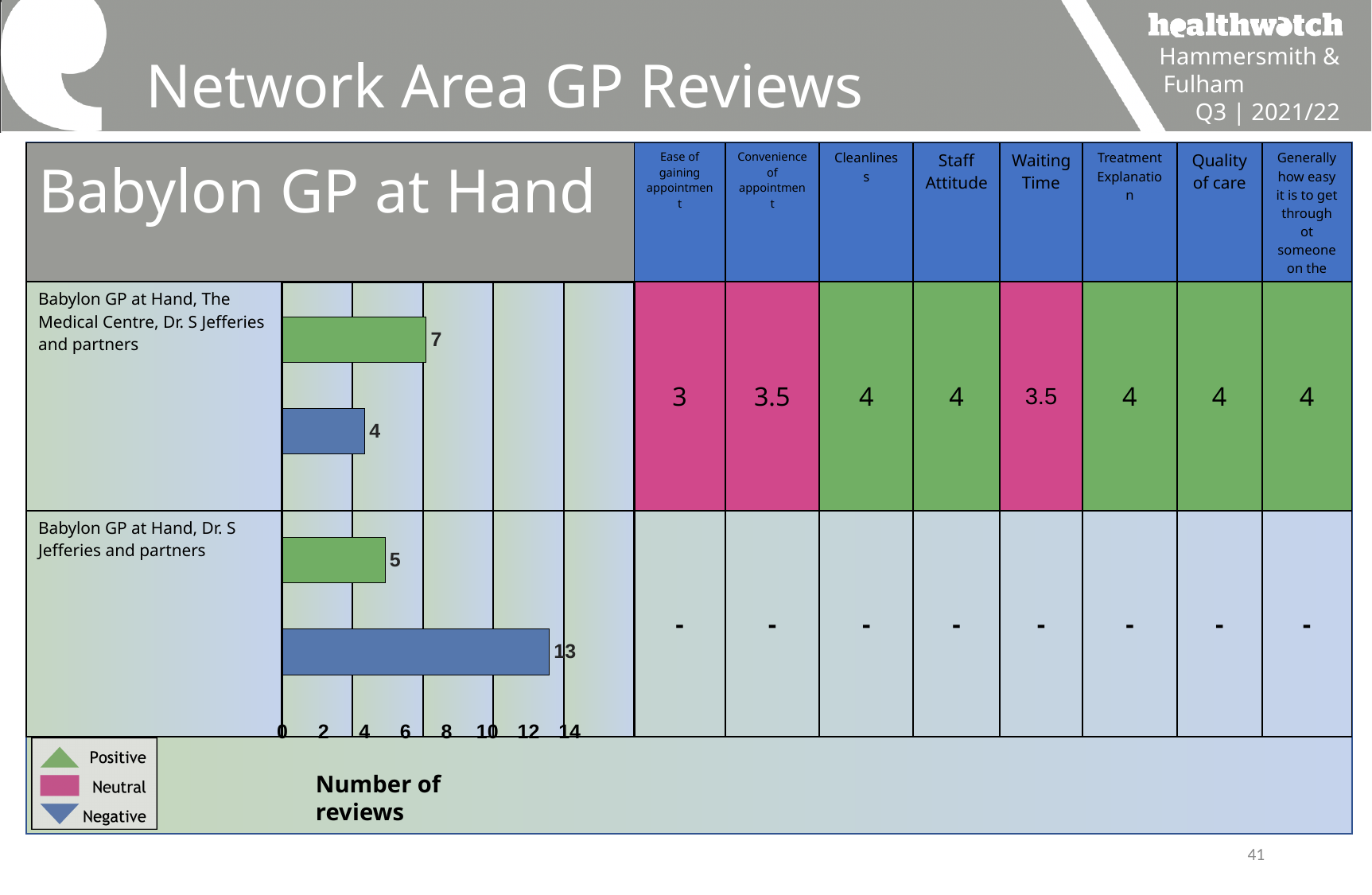
How many entries does the legend list? 3 How many practices are shown in the bar chart? 2 How many positive reviews does Babylon GP at Hand, Dr. S Jefferies and partners have? 5 Which practice has more positive reviews: Babylon GP at Hand, The Medical Centre, Dr. S Jefferies and partners, or Babylon GP at Hand, Dr. S Jefferies and partners? Babylon GP at Hand, The Medical Centre, Dr. S Jefferies and partners What type of chart is used to show the number of reviews on the slide? bar chart How many positive reviews does Babylon GP at Hand, The Medical Centre, Dr. S Jefferies and partners have? 7 Which bar in the chart has the highest value? Negative reviews for Babylon GP at Hand, Dr. S Jefferies and partners Is the number of negative reviews for Babylon GP at Hand, Dr. S Jefferies and partners greater or less than 10? greater How many negative reviews does Babylon GP at Hand, The Medical Centre, Dr. S Jefferies and partners have? 4 How many negative reviews does Babylon GP at Hand, Dr. S Jefferies and partners have? 13 What is the difference between the negative and positive review counts for Babylon GP at Hand, Dr. S Jefferies and partners? 8 What is the difference between the positive and negative review counts for Babylon GP at Hand, The Medical Centre, Dr. S Jefferies and partners? 3